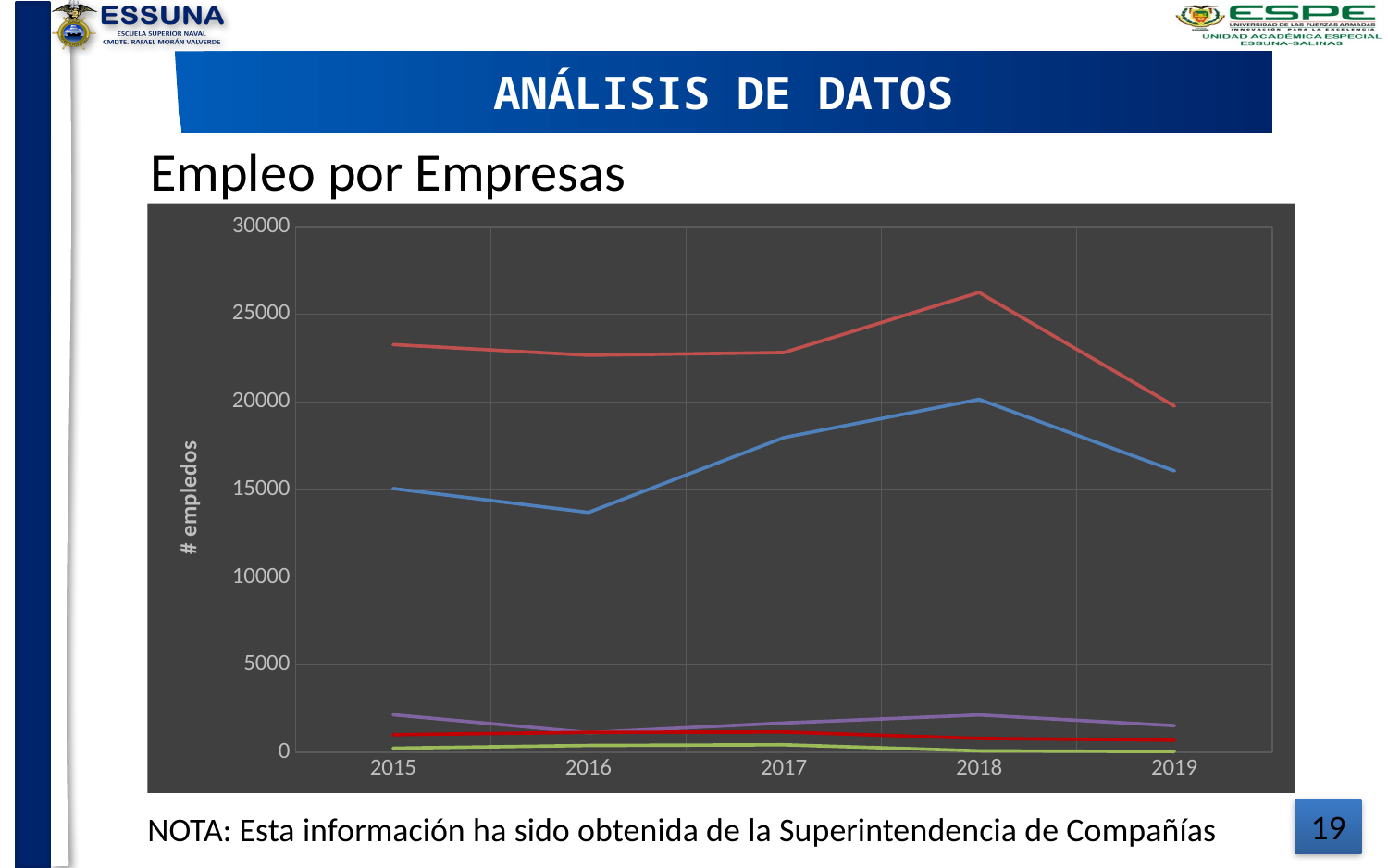
Does the blue line rise or fall between 2016 and 2018? rise In which year does the top (red) line reach its highest value? 2018 Is the value of the top (red) line in 2018 greater or less than 25000? greater In 2015, which is larger: the value of the red line or the value of the blue line? the red line What kind of chart is shown on the slide? line chart What is the label on the y axis of the chart? # empledos Is the value of the blue line in 2017 greater or less than 20000? less Does the top (red) line rise or fall between 2018 and 2019? fall Is the value of the purple line in 2015 greater or less than 5000? less How many years are plotted along the x axis? 5